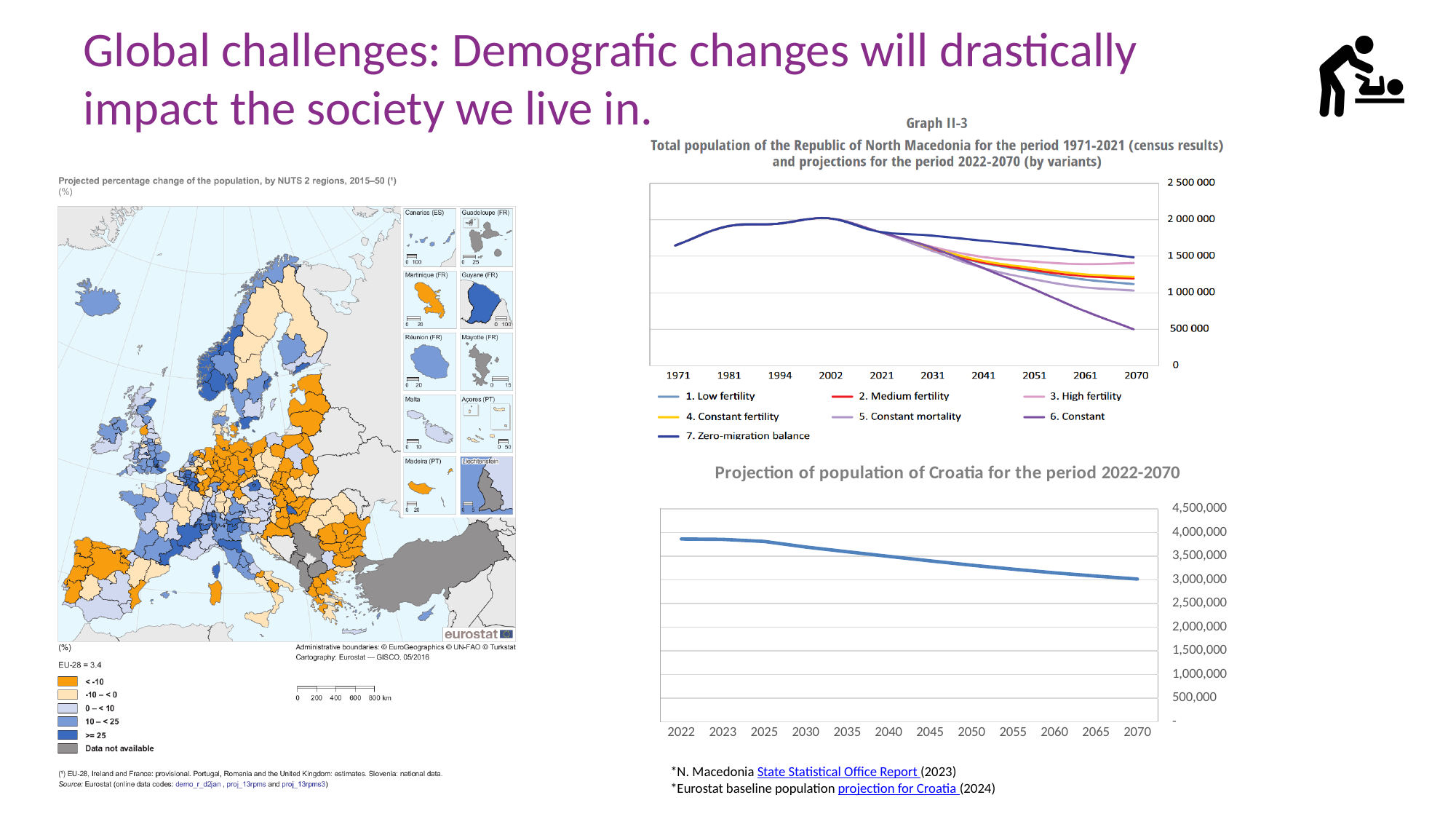
What kind of chart is the 'Projection of population of Croatia for the period 2022-2070'? line chart In the North Macedonia population chart, is the total population in 2002 greater or less than 1 500 000? greater In the Croatia population projection chart, is the value for 2070 greater or less than 2,500,000? greater What kind of chart is the 'Total population of the Republic of North Macedonia' chart? line chart In the North Macedonia population chart, which series has the lowest value in 2070? 6. Constant In the North Macedonia population chart, is the value for '6. Constant' in 2070 greater or less than 1 000 000? less How many series does the legend of the North Macedonia population chart list? 7 In the North Macedonia population chart, do the projected values rise or fall between 2021 and 2070? fall In the North Macedonia population chart, which series has the highest value in 2070? 7. Zero-migration balance How many year labels are shown on the x axis of the North Macedonia population chart? 10 In the Croatia population projection chart, does the population rise or fall from 2022 to 2070? fall